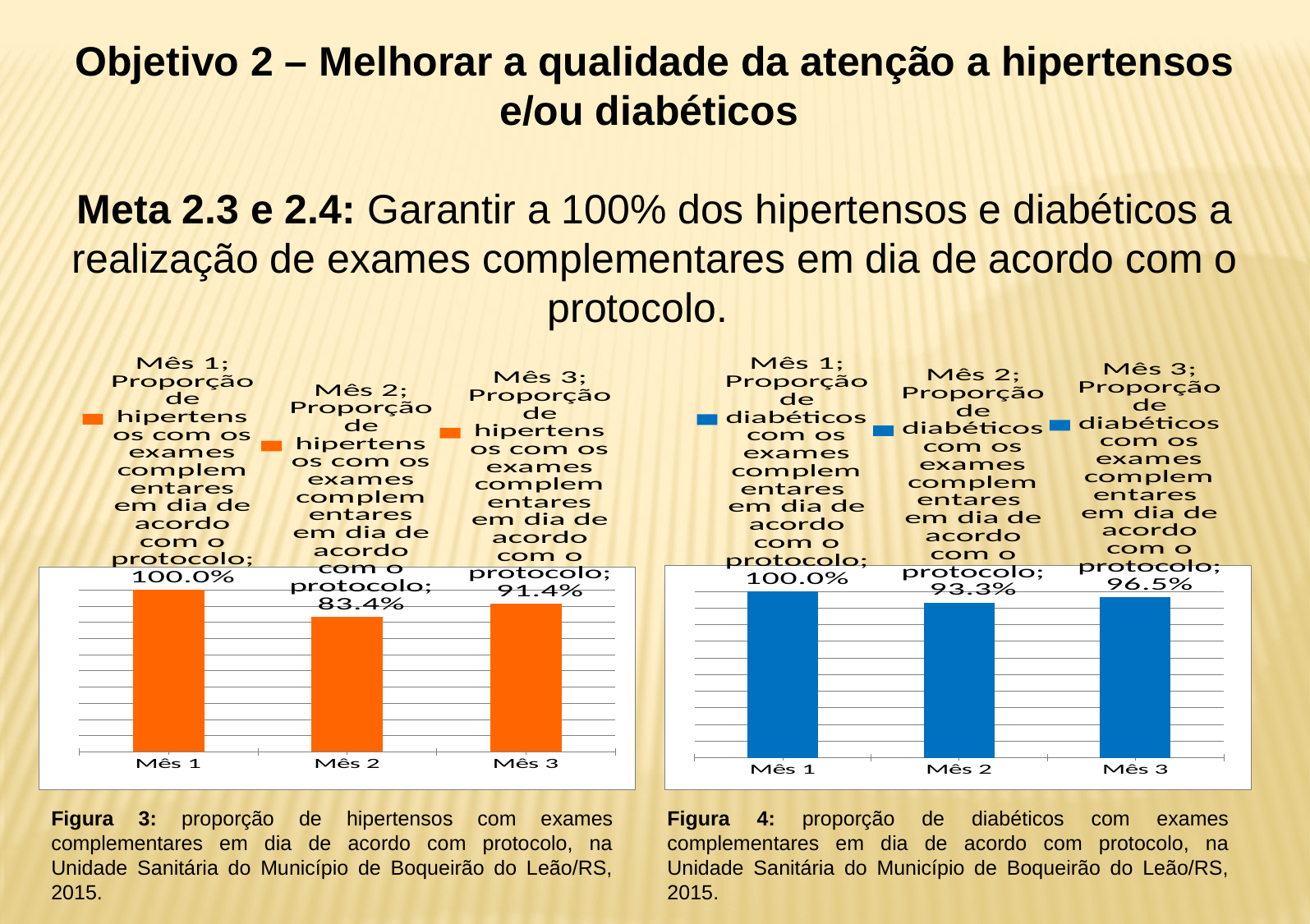
What type of chart is the right chart (Figura 4, diabéticos)? Bar chart In the left chart (Figura 3, hipertensos), which month has the lowest value? Mês 2 In the left chart (Figura 3, hipertensos), what is the difference between the values for Mês 1 and Mês 2? 16.6% In the right chart (Figura 4, diabéticos), what is the value for Mês 2? 93.3% In the right chart (Figura 4, diabéticos), what is the value for Mês 3? 96.5% In the left chart (Figura 3, hipertensos), what is the value for Mês 2? 83.4% In the left chart (Figura 3, hipertensos), what is the value for Mês 3? 91.4% In the right chart (Figura 4, diabéticos), what is the difference between the values for Mês 3 and Mês 2? 3.2% What colour are the bars in the left chart (Figura 3, hipertensos)? Orange How many months (categories) are shown in the left chart (Figura 3, hipertensos)? 3 In the right chart (Figura 4, diabéticos), which month has the highest value? Mês 1 In the right chart (Figura 4, diabéticos), which is larger, the value for Mês 2 or Mês 3? Mês 3